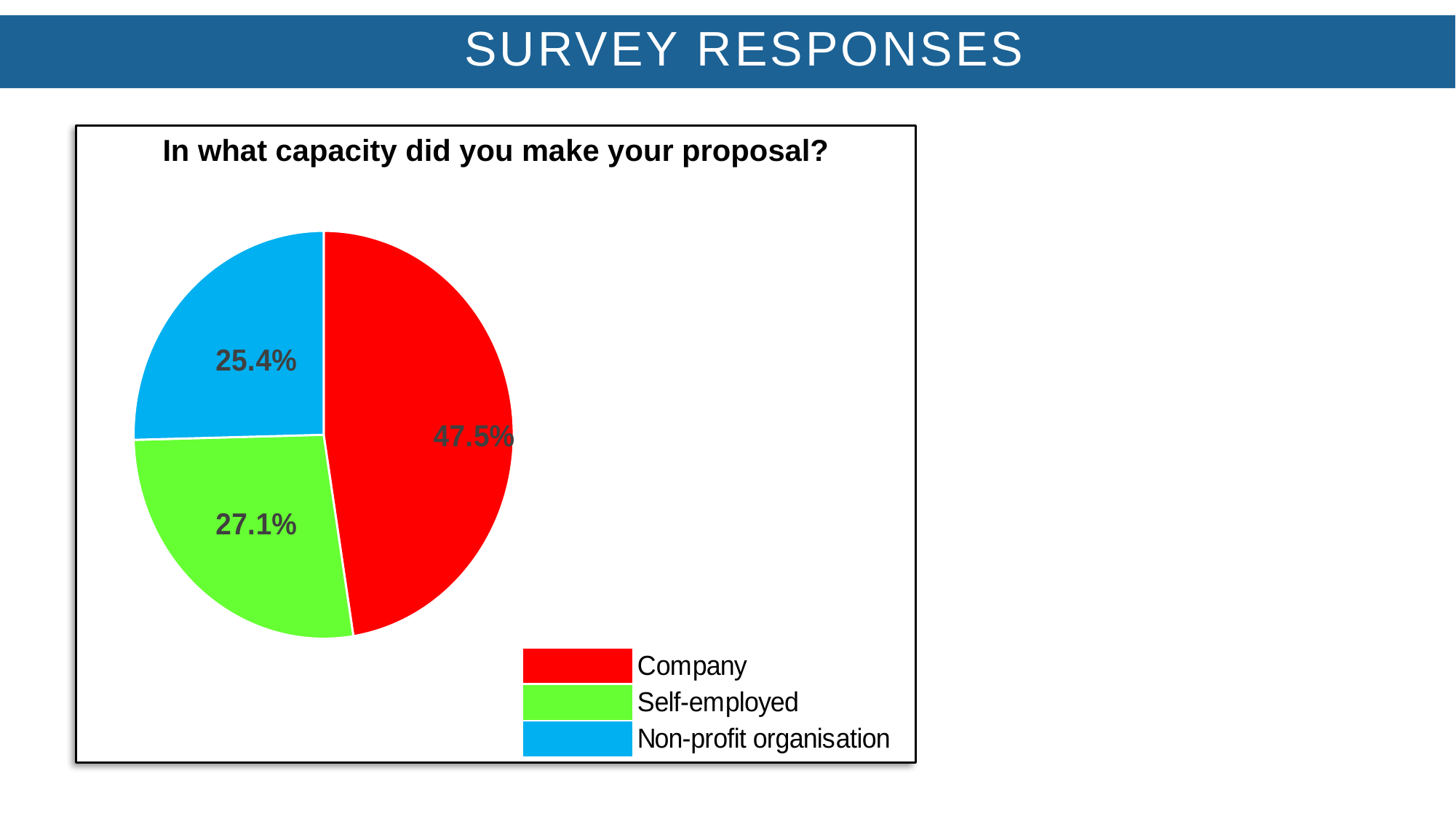
How many categories are shown in the pie chart? 3 Which is larger, the Company share or the Non-profit organisation share? Company Which category has the smallest share of the pie? Non-profit organisation What is the difference in percentage points between the Company share and the Self-employed share? 20.4 Which category has the largest share of the pie? Company What percentage of respondents made their proposal as a Company? 47.5% What is the title of the chart? In what capacity did you make your proposal? What is the difference in percentage points between the Self-employed share and the Non-profit organisation share? 1.7 What kind of chart is shown on the slide? Pie chart What colour represents Self-employed in the pie chart? Green What percentage of respondents made their proposal as a Non-profit organisation? 25.4% What percentage of respondents made their proposal as Self-employed? 27.1%